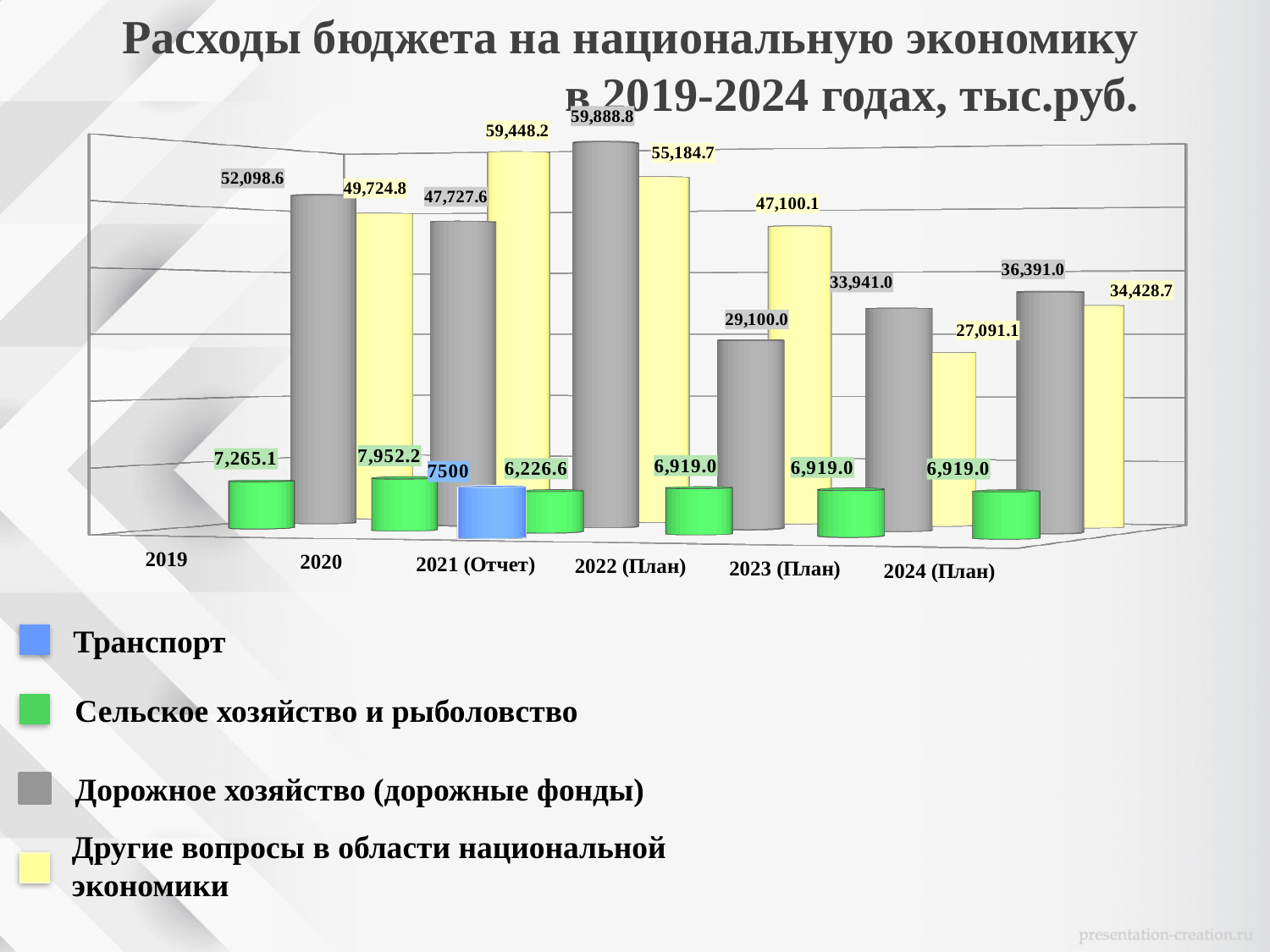
What is the value for Дорожное хозяйство (дорожные фонды) in 2019? 52,098.6 Which is larger in 2023 (План): Дорожное хозяйство (дорожные фонды) or Другие вопросы в области национальной экономики? Дорожное хозяйство (дорожные фонды) How many series does the legend list? 4 How many years are shown on the x axis? 6 In which year is the value for Другие вопросы в области национальной экономики the lowest? 2023 (План) In which year is the value for Дорожное хозяйство (дорожные фонды) the highest? 2021 (Отчет) What is the difference between the Дорожное хозяйство (дорожные фонды) values in 2021 (Отчет) and 2022 (План)? 30,788.8 What kind of chart is shown on the slide? Bar chart What is the value for Другие вопросы в области национальной экономики in 2020? 59,448.2 What is the value for Сельское хозяйство и рыболовство in 2024 (План)? 6,919.0 What is the value for Транспорт in 2021 (Отчет)? 7500 Which series is shown in blue in the legend? Транспорт